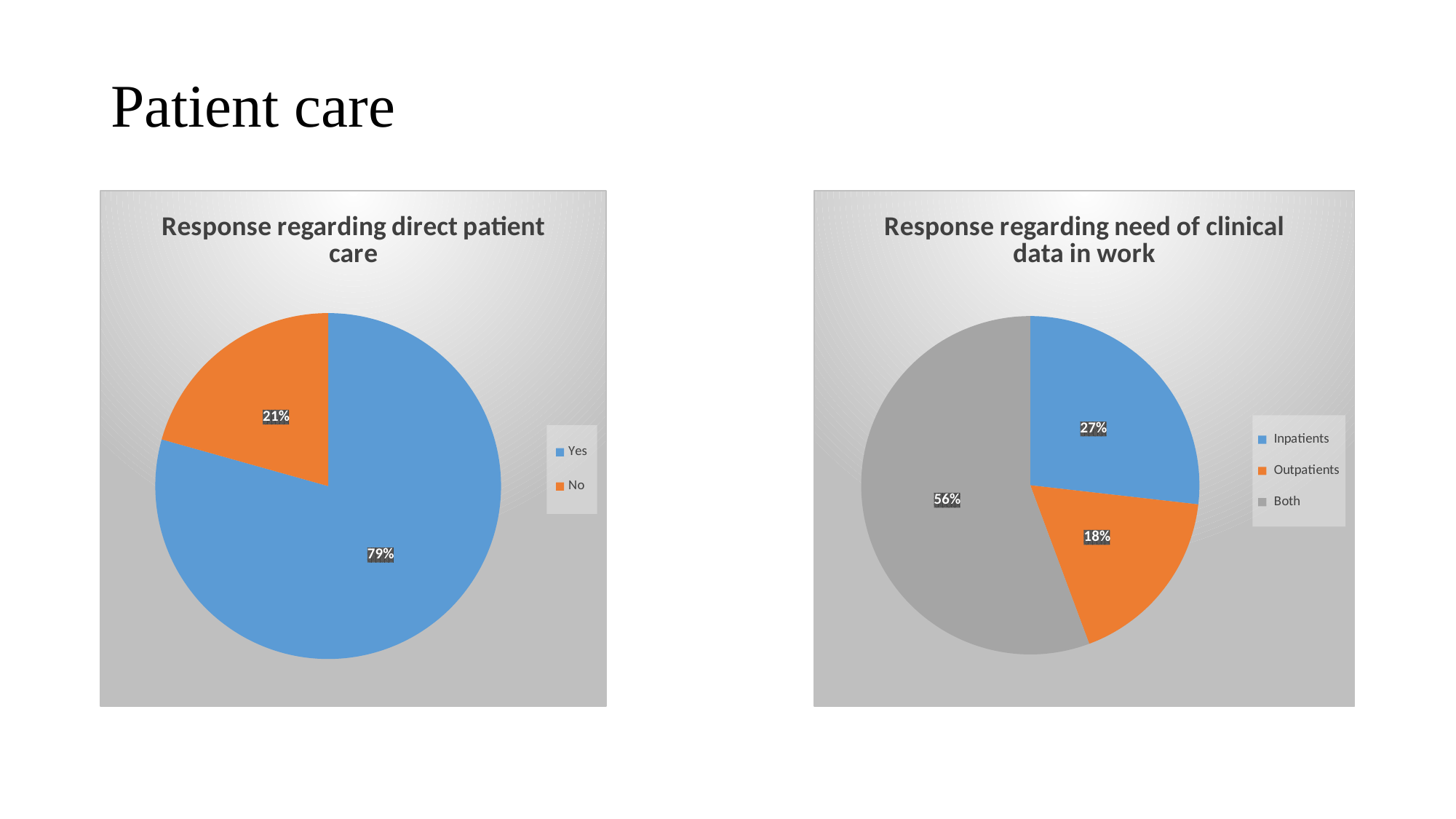
In the 'Response regarding need of clinical data in work' chart, what share is 'Inpatients'? 27% In the 'Response regarding direct patient care' chart, what is the difference between the 'Yes' and 'No' shares? 58% In the 'Response regarding direct patient care' chart, which category has the largest slice? Yes What kind of chart is the 'Response regarding direct patient care' chart? Pie chart In the 'Response regarding need of clinical data in work' chart, which category has the smallest slice? Outpatients In the 'Response regarding direct patient care' chart, what share of responses is 'Yes'? 79% In the 'Response regarding direct patient care' chart, what share of responses is 'No'? 21% In the 'Response regarding need of clinical data in work' chart, what share is 'Outpatients'? 18% In the 'Response regarding need of clinical data in work' chart, which is larger: 'Inpatients' or 'Outpatients'? Inpatients How many categories does the legend of the 'Response regarding need of clinical data in work' chart list? 3 In the 'Response regarding need of clinical data in work' chart, which category has the largest slice? Both How many categories does the legend of the 'Response regarding direct patient care' chart list? 2